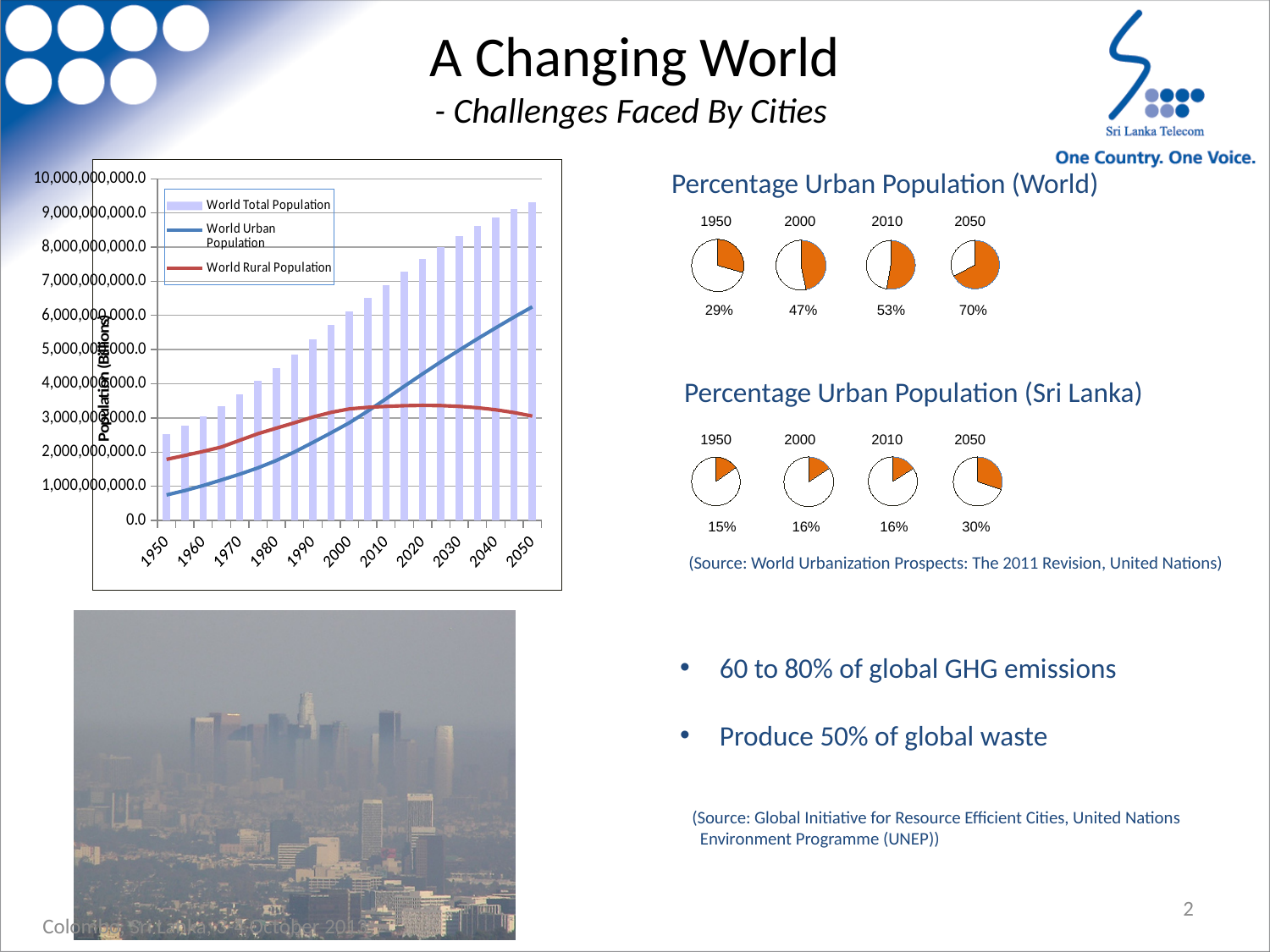
In the left-hand population chart, does the World Urban Population line rise or fall from 1950 to 2050? rise In the 'Percentage Urban Population (World)' pie charts, which year has the lowest urban share? 1950 In the 'Percentage Urban Population (World)' pie charts, what is the difference between the 2050 share and the 1950 share? 41% What kind of chart is the population chart on the left of the slide? A combined bar and line chart In the left-hand population chart, is the World Urban Population value for 1950 greater or less than 1,000,000,000.0? less In the 'Percentage Urban Population (Sri Lanka)' pie charts, what is the urban share shown for 1950? 15% How many series does the legend of the left-hand population chart list? 3 In the left-hand population chart, is the World Urban Population value for 2050 greater or less than 6,000,000,000.0? greater In the left-hand population chart, is the World Total Population bar for 2050 greater or less than 9,000,000,000.0? greater How many pie charts are shown in the 'Percentage Urban Population (Sri Lanka)' row? 4 In the 'Percentage Urban Population (World)' pie charts, what is the urban share shown for 2050? 70% In the left-hand population chart, which is larger in 2050: World Urban Population or World Rural Population? World Urban Population